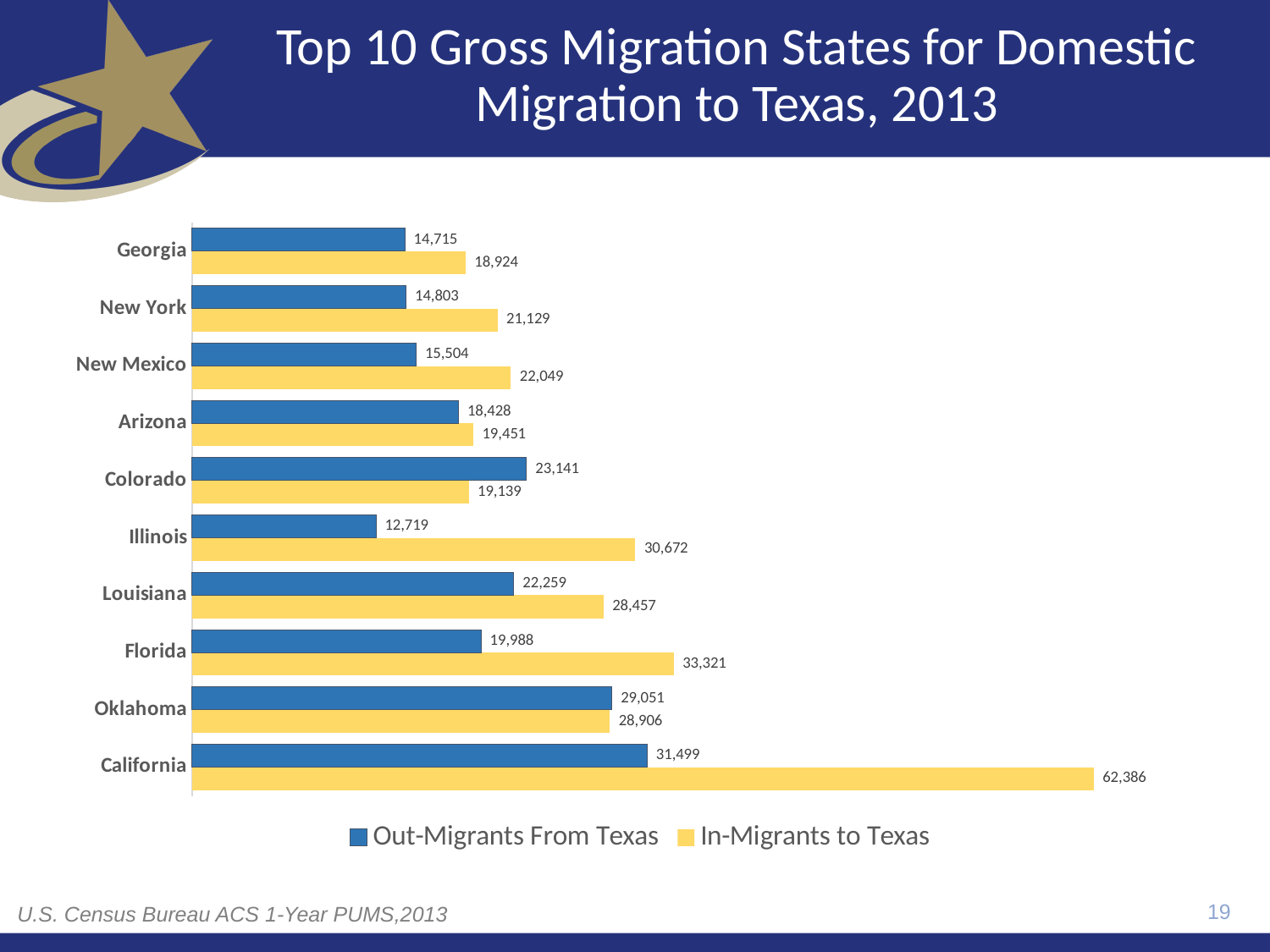
Which colour represents In-Migrants to Texas in the chart? Yellow What kind of chart is shown on the slide? Bar chart What is the number of Out-Migrants From Texas to Illinois? 12,719 Which state has the highest number of In-Migrants to Texas? California What is the number of In-Migrants to Texas from California? 62,386 What is the total of Out-Migrants From Texas and In-Migrants to Texas for Oklahoma? 57,957 Which state has the lowest number of Out-Migrants From Texas? Illinois How many series does the legend list? 2 How many states are shown on the chart? 10 For Colorado, which is larger: Out-Migrants From Texas or In-Migrants to Texas? Out-Migrants From Texas What is the difference between In-Migrants to Texas and Out-Migrants From Texas for Illinois? 17,953 What is the number of In-Migrants to Texas from Florida? 33,321